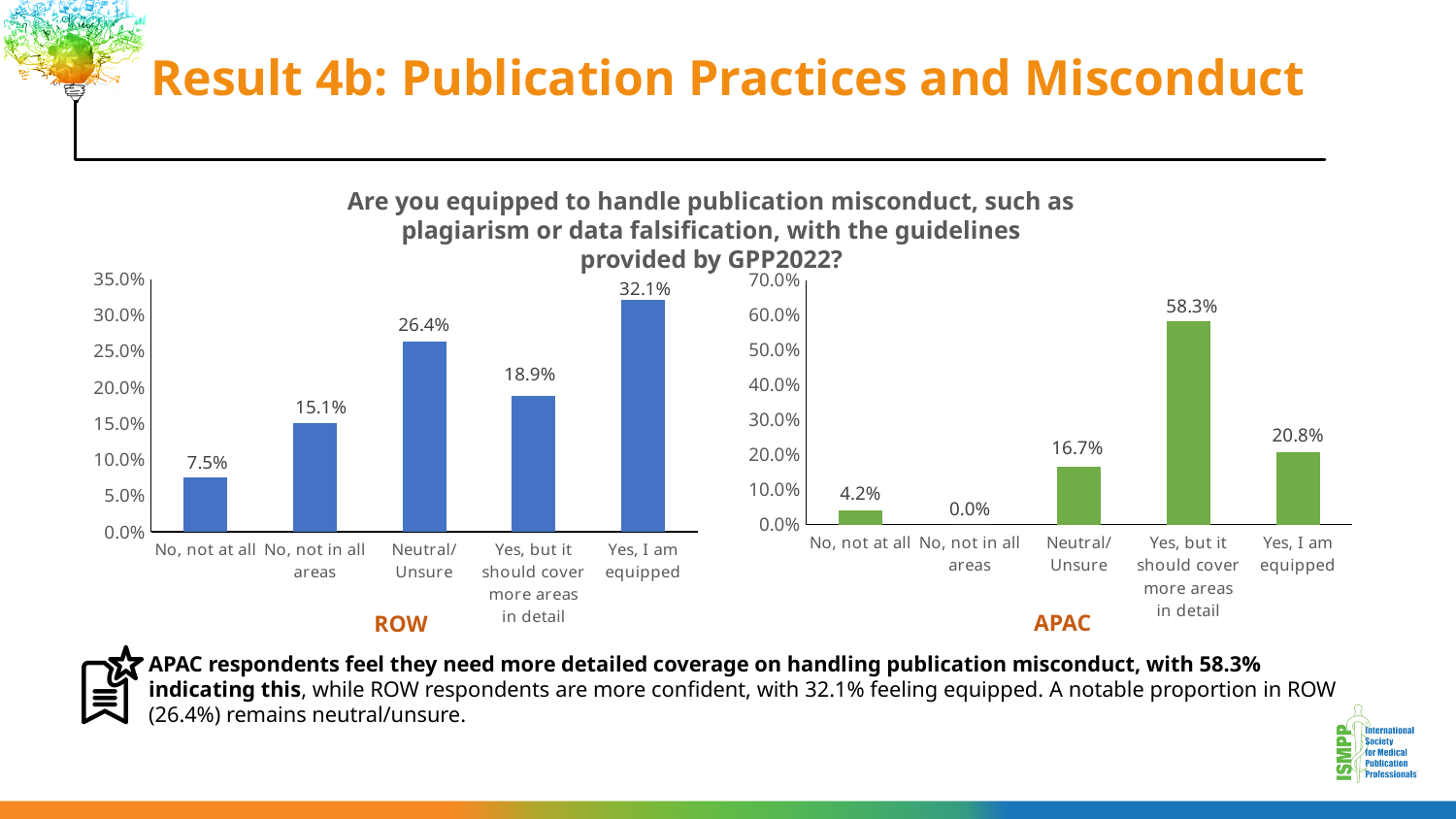
In the APAC chart, which category has the lowest value? No, not in all areas How many categories are shown in the APAC chart? 5 In the APAC chart, what is the difference between "Yes, I am equipped" and "Neutral/Unsure"? 4.1% In the ROW chart, which category has the highest value? Yes, I am equipped Which is larger: the "Neutral/Unsure" value in the ROW chart or in the APAC chart? ROW In the ROW chart, what is the difference between "Yes, I am equipped" and "Yes, but it should cover more areas in detail"? 13.2% In the APAC chart, what is the value for "No, not in all areas"? 0.0% In the ROW chart, which category has the lowest value? No, not at all In the APAC chart, what is the value for "Yes, but it should cover more areas in detail"? 58.3% In the ROW chart, what is the value for "Yes, I am equipped"? 32.1% What type of chart is the ROW chart? Bar chart In the ROW chart, what is the value for "Neutral/Unsure"? 26.4%